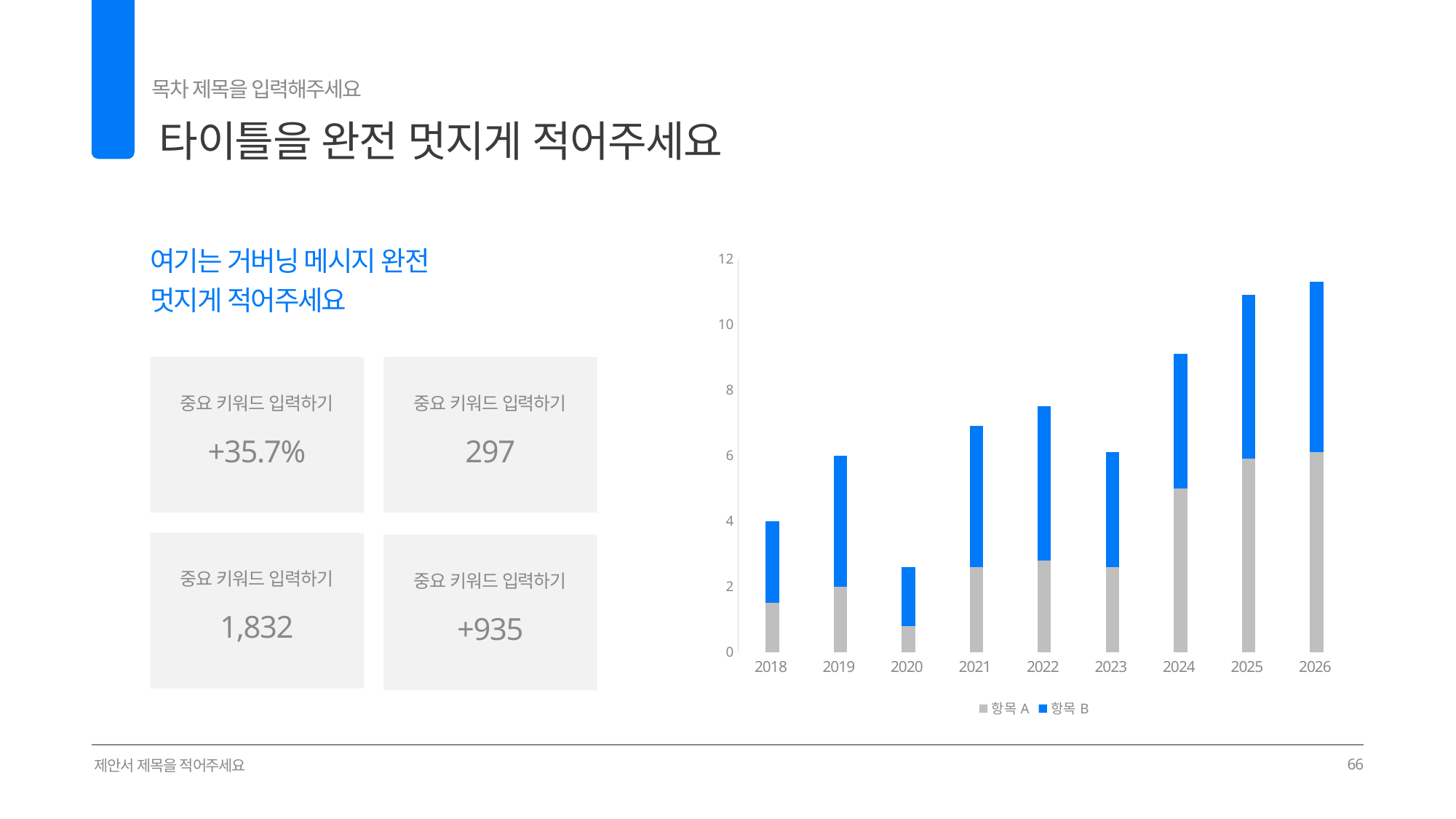
Is the total stacked value for 2025 greater or less than 10? greater Which colour represents 항목 B in the chart? Blue Is the 항목 A value for 2024 greater or less than 4? greater Is the total stacked value for 2024 greater or less than 8? greater What kind of chart is shown on the slide? Stacked bar chart How many series does the chart legend list? 2 Which year has the larger total stacked bar, 2023 or 2024? 2024 How many years are shown on the x axis of the chart? 9 Does the total stacked value fall or rise from 2022 to 2023? fall Which year has the tallest stacked bar in the chart? 2026 Which year has the shortest stacked bar in the chart? 2020